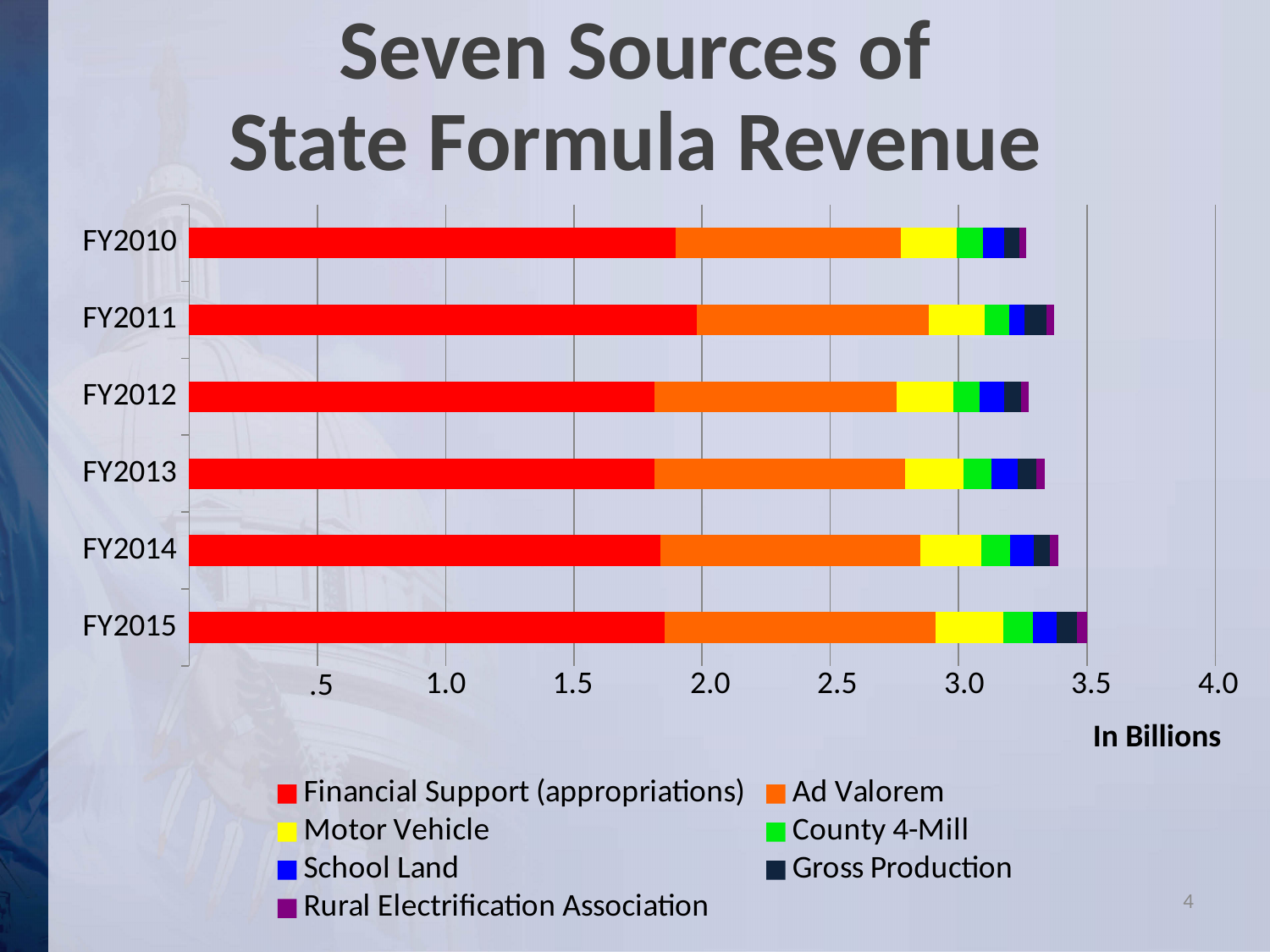
What unit does the chart say the values are in? In Billions Is the total stacked bar for FY2010 greater or less than 3.5? less What is the title of the chart? Seven Sources of State Formula Revenue Is the total stacked bar for FY2015 greater or less than 3.0? greater Which is larger, the total stacked bar for FY2015 or for FY2012? FY2015 How many series does the legend list? 7 Is the Financial Support (appropriations) value for FY2015 greater or less than 2.0? less Which is larger, the Financial Support (appropriations) value for FY2011 or for FY2012? FY2011 Which fiscal year has the longest total stacked bar? FY2015 How many fiscal years are plotted on the chart? 6 What kind of chart is shown on the slide? Stacked bar chart